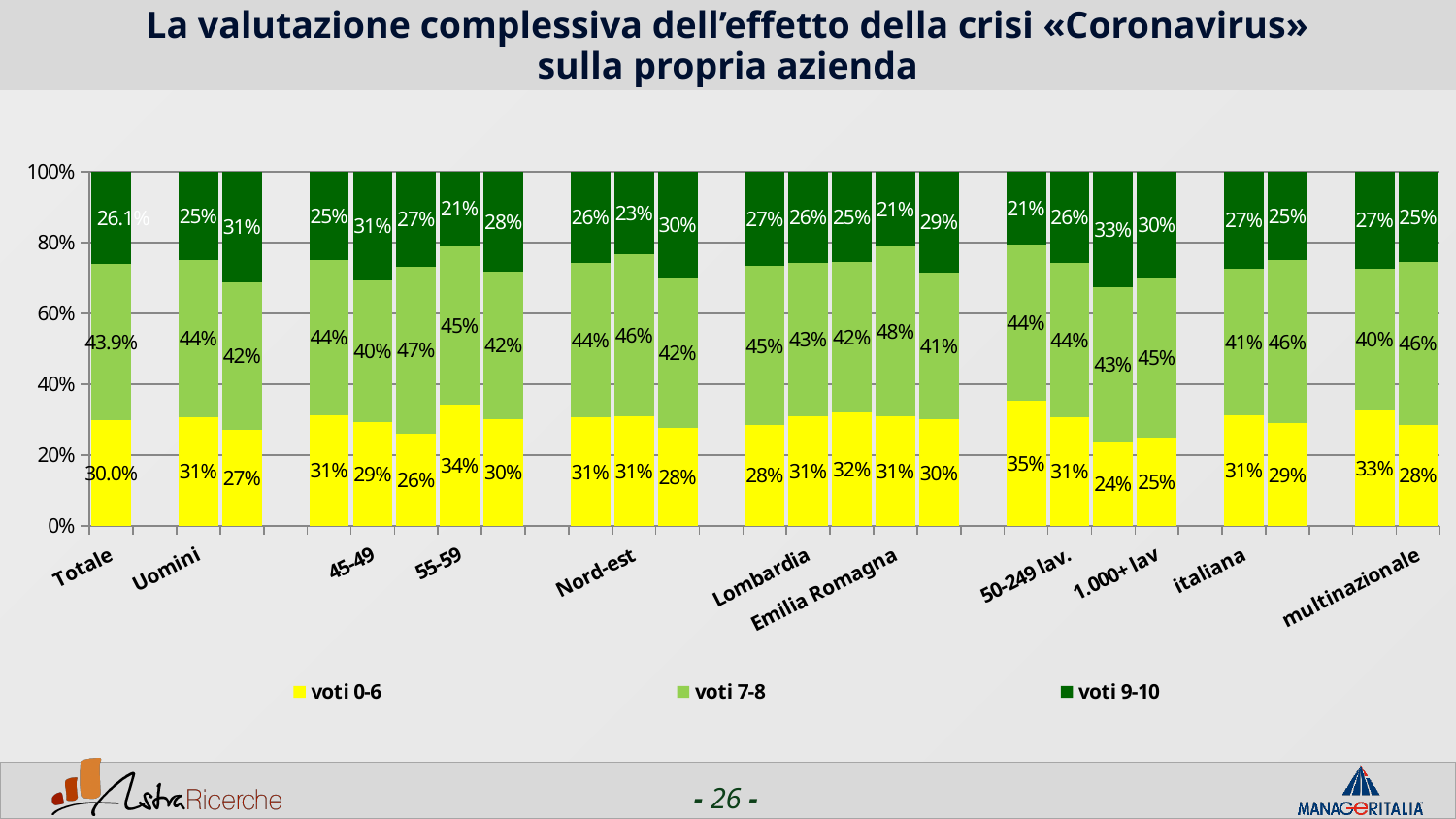
What is the value of 'voti 9-10' for Totale? 26.1% What kind of chart is shown on the slide? stacked bar chart What is the value of 'voti 9-10' for Uomini? 25% For Uomini, what is the difference between 'voti 7-8' and 'voti 0-6'? 13% What is the value of 'voti 7-8' for Uomini? 44% What is the value of 'voti 0-6' for Uomini? 31% What is the value of 'voti 0-6' for Totale? 30.0% How many series does the legend list? 3 What are the three series named in the legend? voti 0-6, voti 7-8, voti 9-10 Which colour represents the 'voti 9-10' series? dark green What is the value of 'voti 7-8' for Totale? 43.9% For Totale, which is larger: 'voti 7-8' or 'voti 9-10'? voti 7-8